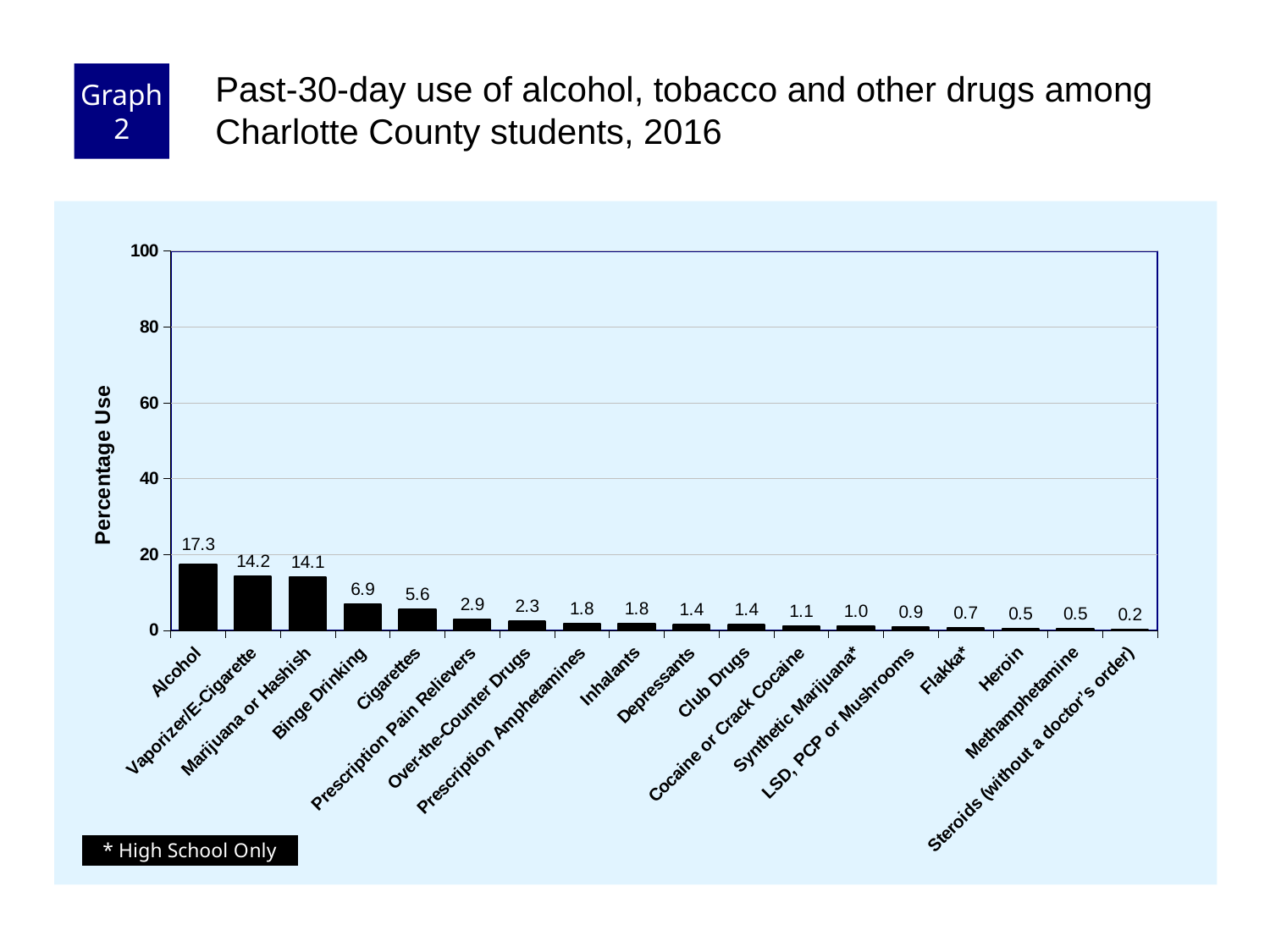
Which has a higher percentage use, Binge Drinking or Cigarettes? Binge Drinking Which category has the highest percentage use? Alcohol Which category has the lowest percentage use? Steroids (without a doctor's order) What kind of chart is shown on the slide? Bar chart What is the percentage use for Heroin? 0.5 Is the value for Alcohol greater or less than 20? less What is the percentage use for Cigarettes? 5.6 What is the label on the y axis? Percentage Use What is the percentage use for Binge Drinking? 6.9 What is the difference in percentage use between Alcohol and Vaporizer/E-Cigarette? 3.1 How many categories are shown on the x axis? 18 What is the percentage use for Alcohol? 17.3